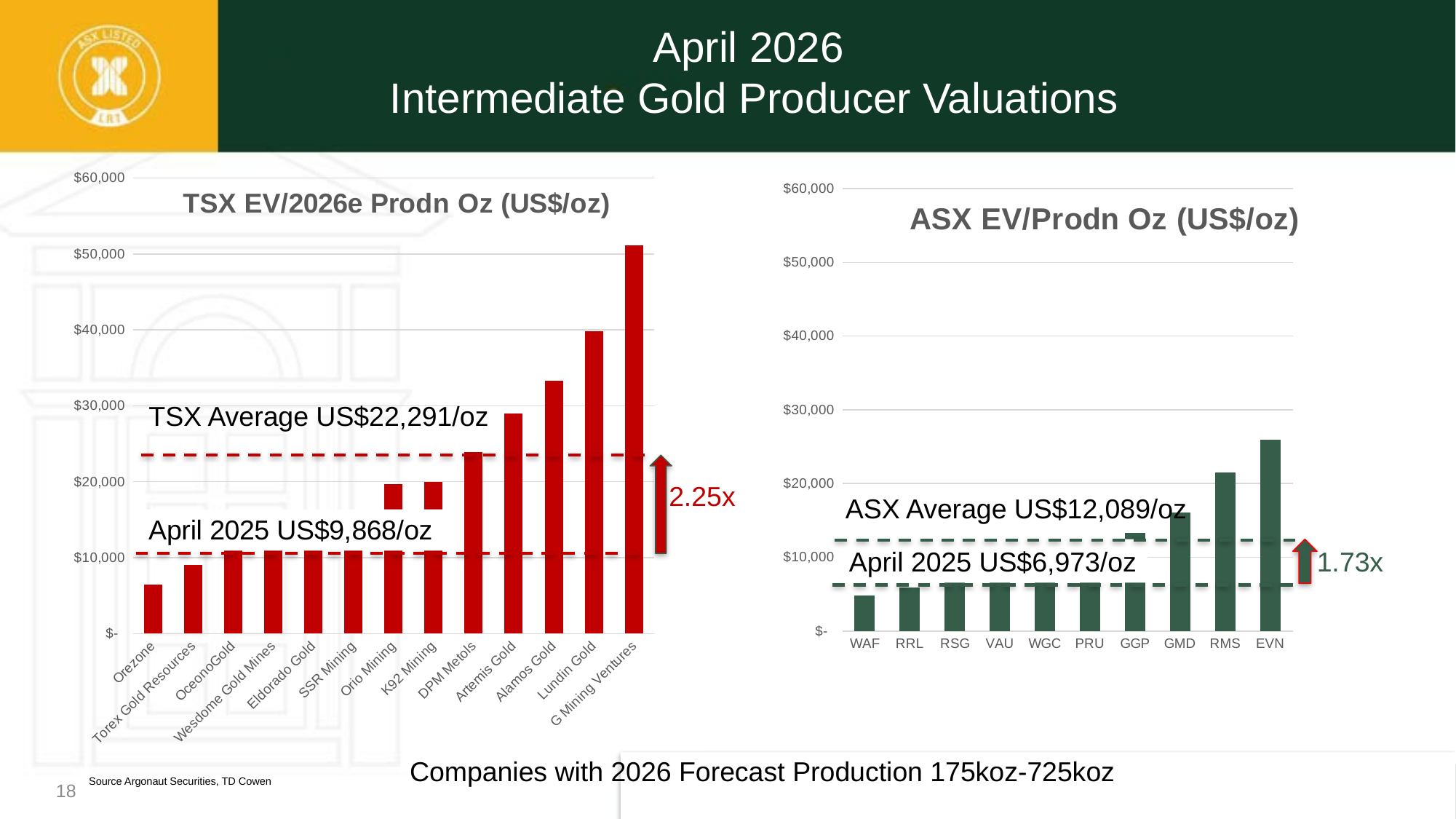
In the ASX EV/Prodn Oz (US$/oz) chart, which company has the highest value? EVN In the TSX EV/2026e Prodn Oz (US$/oz) chart, what is the TSX Average value shown? US$22,291/oz In the TSX EV/2026e Prodn Oz (US$/oz) chart, which company has the lowest value? Orezone In the TSX EV/2026e Prodn Oz (US$/oz) chart, which company has the highest value? G Mining Ventures How many companies are shown in the TSX EV/2026e Prodn Oz (US$/oz) chart? 13 In the ASX EV/Prodn Oz (US$/oz) chart, what is the ASX Average value shown? US$12,089/oz What kind of chart is the TSX EV/2026e Prodn Oz (US$/oz) chart? bar chart In the TSX EV/2026e Prodn Oz (US$/oz) chart, what was the April 2025 average value shown? US$9,868/oz In the TSX EV/2026e Prodn Oz (US$/oz) chart, do the values rise or fall from left to right? rise In the ASX EV/Prodn Oz (US$/oz) chart, is the value for EVN greater or less than $20,000? greater In the TSX EV/2026e Prodn Oz (US$/oz) chart, is the value for Alamos Gold greater or less than $30,000? greater How many companies are shown in the ASX EV/Prodn Oz (US$/oz) chart? 10